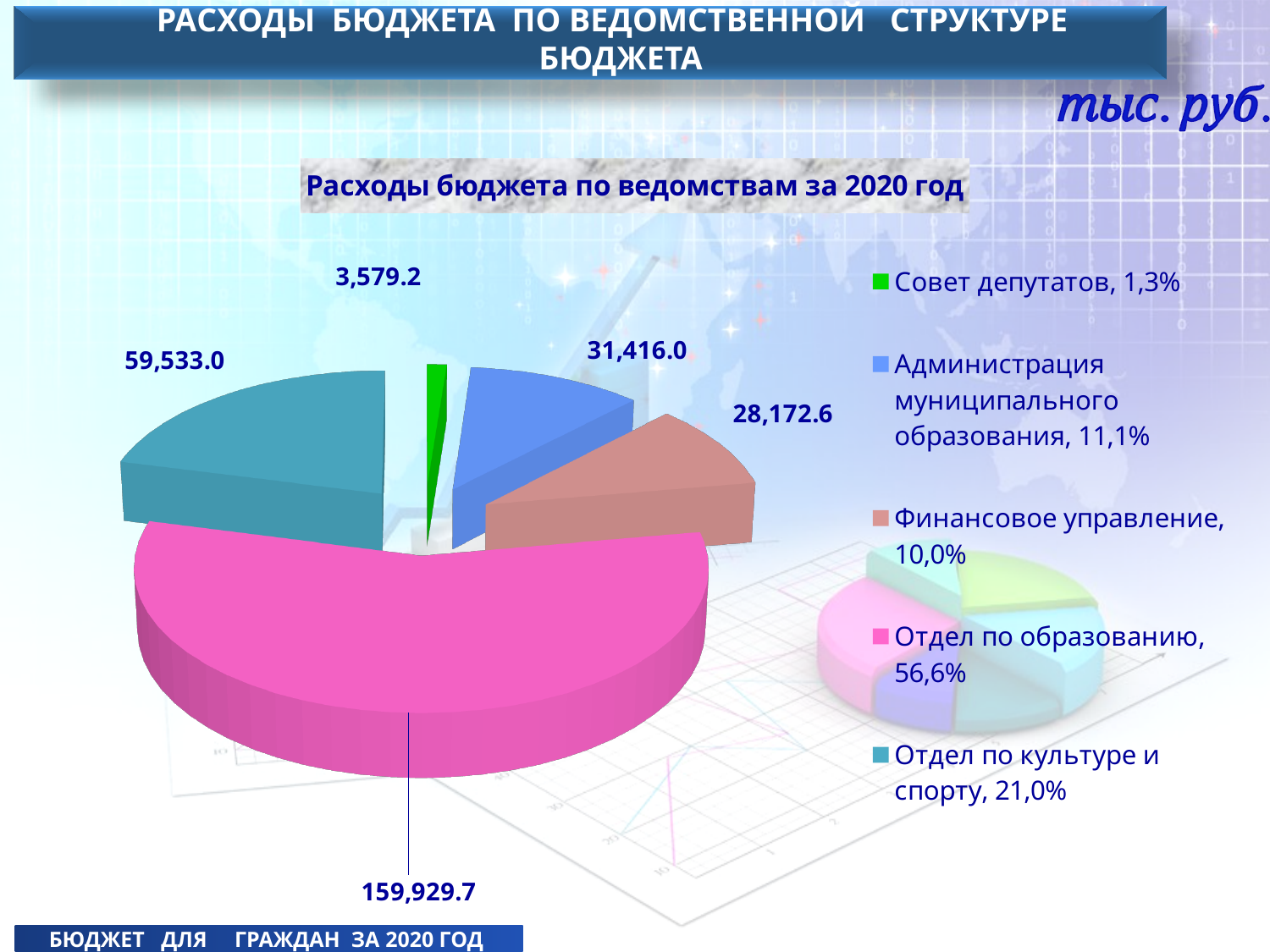
What is the value for Отдел по образованию? 159,929.7 What is the title of the chart? Расходы бюджета по ведомствам за 2020 год Which is larger: the value for Администрация муниципального образования or the value for Финансовое управление? Администрация муниципального образования What is the value for Финансовое управление? 28,172.6 What share of the pie does Отдел по культуре и спорту represent, according to the legend? 21,0% What is the value for Отдел по культуре и спорту? 59,533.0 How many categories does the legend of the pie chart list? 5 Which category has the largest slice of the pie? Отдел по образованию Which category has the smallest slice of the pie? Совет депутатов What kind of chart is shown on the slide? pie chart What is the value for Совет депутатов? 3,579.2 What is the difference between the values for Отдел по образованию and Отдел по культуре и спорту? 100,396.7